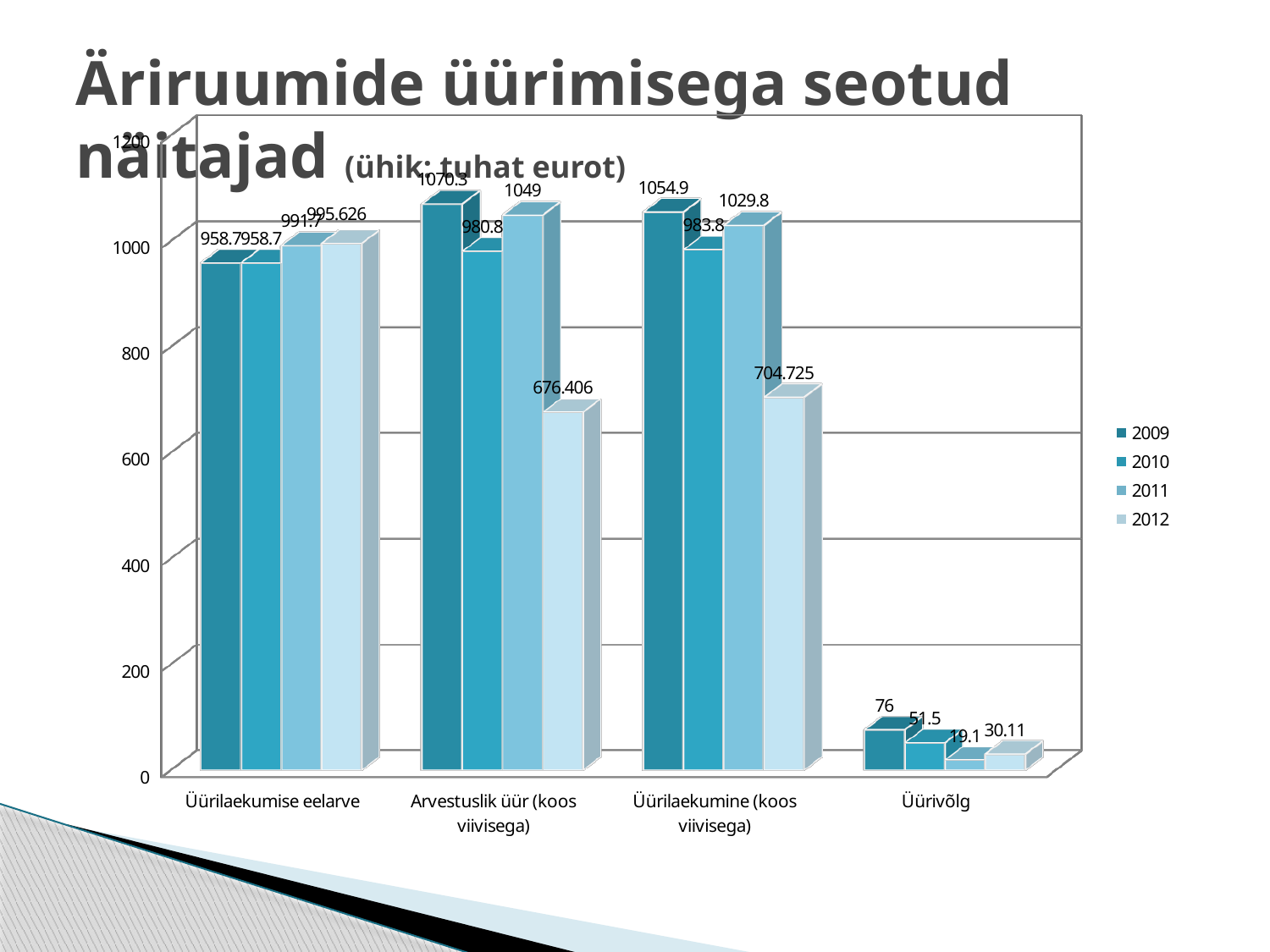
What is the value for Üürilaekumise eelarve in 2012? 995.626 Is the value for Üürilaekumine (koos viivisega) in 2012 greater or less than 800? less How many series does the legend list? 4 What is the value for Arvestuslik üür (koos viivisega) in 2012? 676.406 For Üürivõlg, which year has the highest value? 2009 What is the value for Üürivõlg in 2009? 76 What kind of chart is shown on the slide? bar chart For Arvestuslik üür (koos viivisega), which year has the lowest value? 2012 How many categories are shown on the x axis? 4 For Üürilaekumine (koos viivisega), which is larger: the 2009 value or the 2010 value? 2009 What is the difference between the 2009 and 2010 values for Üürivõlg? 24.5 What is the value for Üürilaekumine (koos viivisega) in 2011? 1029.8